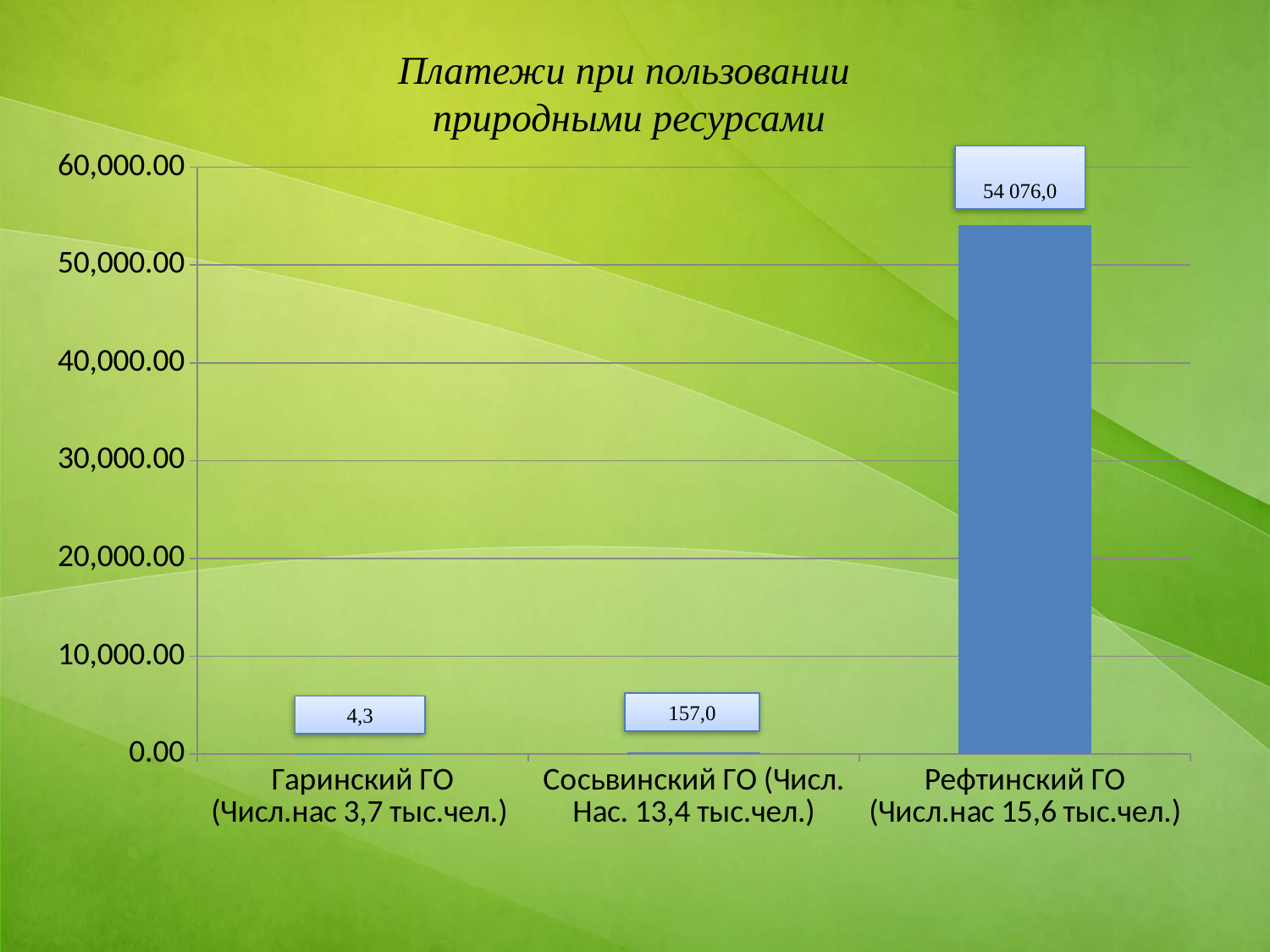
What is the value for Рефтинский ГО? 54 076,0 Which category has the highest value? Рефтинский ГО What is the value for Гаринский ГО? 4,3 What is the value for Сосьвинский ГО? 157,0 Which category has the lowest value? Гаринский ГО What is the title of the chart? Платежи при пользовании природными ресурсами Is the value for Рефтинский ГО greater or less than 50,000.00? greater How many categories are shown on the x axis? 3 What is the difference between the values for Сосьвинский ГО and Гаринский ГО? 152,7 Which is larger, the value for Сосьвинский ГО or the value for Гаринский ГО? Сосьвинский ГО What is the difference between the values for Рефтинский ГО and Сосьвинский ГО? 53 919,0 What kind of chart is shown on the slide? bar chart